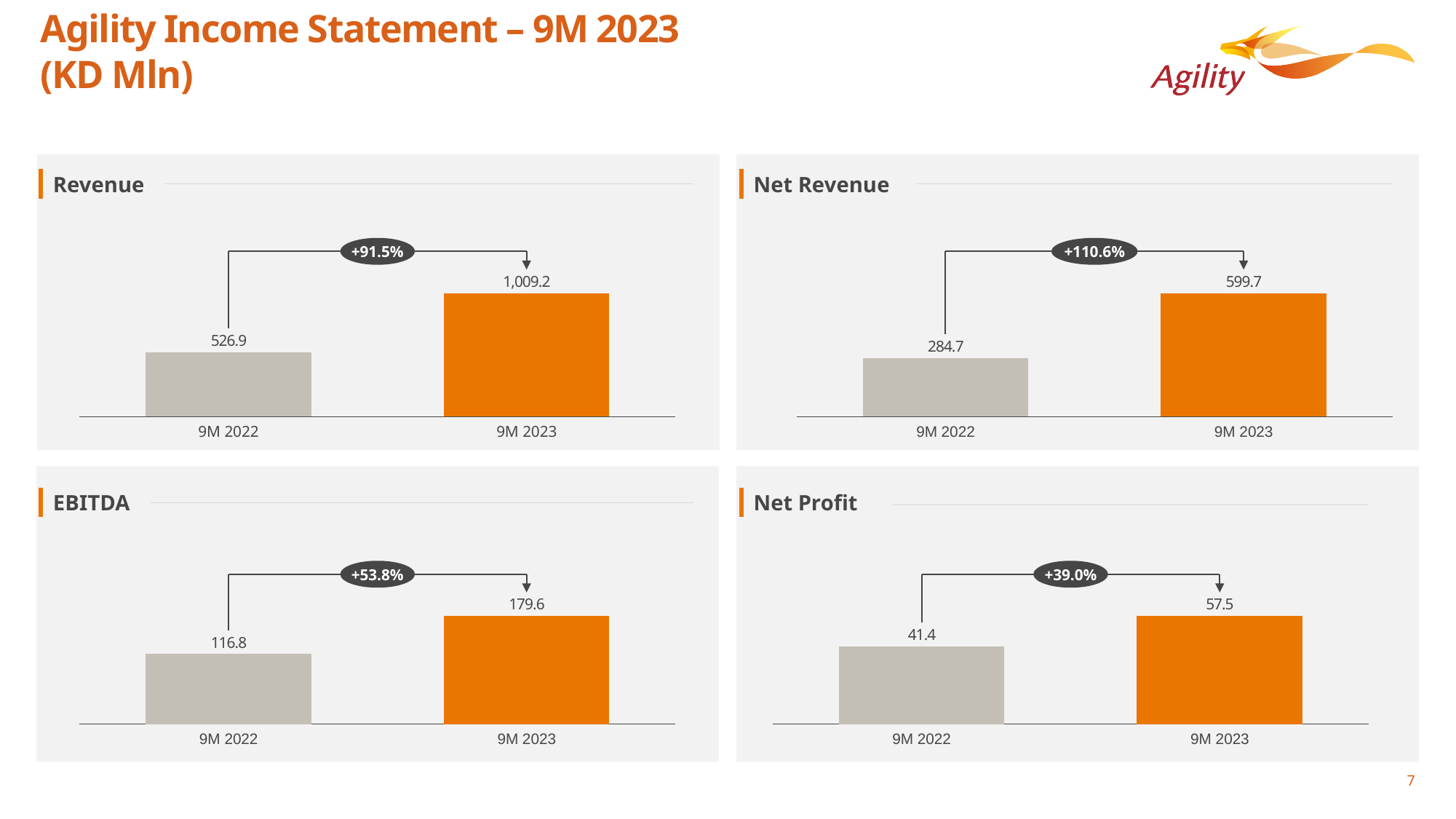
In the Net Revenue chart, what is the difference between the 9M 2023 and 9M 2022 values? 315.0 In the EBITDA chart, what is the value for 9M 2022? 116.8 In the Net Profit chart, which period has the higher value? 9M 2023 In the Net Revenue chart, what percentage change is shown between 9M 2022 and 9M 2023? +110.6% How many bars are shown in the EBITDA chart? 2 In the Revenue chart, what is the value for 9M 2023? 1,009.2 In the Net Revenue chart, what is the value for 9M 2023? 599.7 In the Net Profit chart, what is the value for 9M 2023? 57.5 What kind of chart is the Net Profit chart? bar chart In the Revenue chart, is the value for 9M 2023 larger or smaller than the value for 9M 2022? larger In the EBITDA chart, which period has the lower value? 9M 2022 In the Revenue chart, what is the value for 9M 2022? 526.9